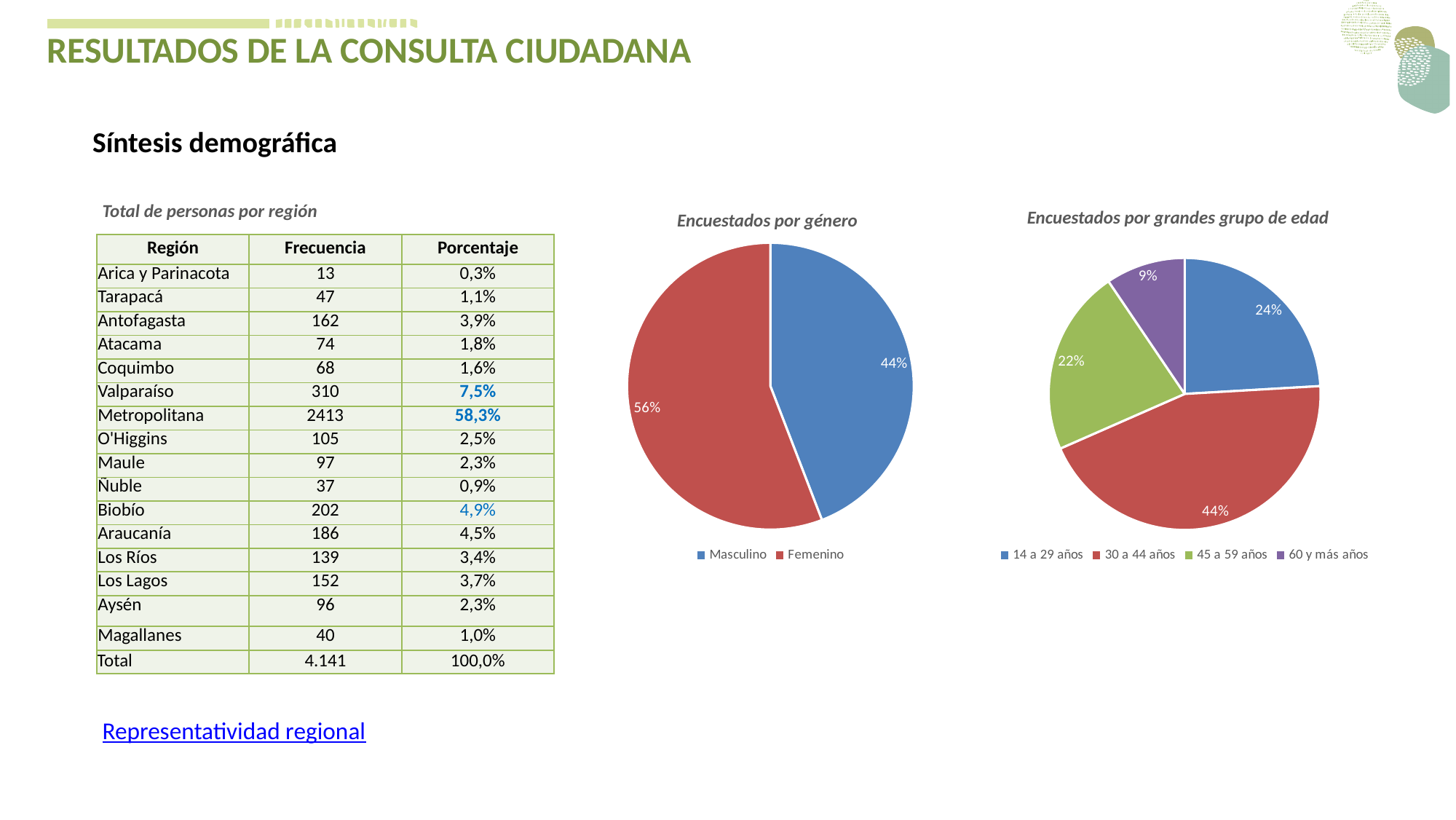
In the 'Encuestados por grandes grupo de edad' chart, what share is '60 y más años'? 9% In the 'Encuestados por género' chart, what is the difference between the Femenino and Masculino shares? 12% In the 'Encuestados por género' chart, which category has the larger share? Femenino In the 'Encuestados por género' chart, what share is Masculino? 44% How many categories does the legend of the 'Encuestados por grandes grupo de edad' chart list? 4 In the 'Encuestados por grandes grupo de edad' chart, what is the difference between the '14 a 29 años' and '45 a 59 años' shares? 2% In the 'Encuestados por grandes grupo de edad' chart, which age group has the smallest share? 60 y más años In the 'Encuestados por grandes grupo de edad' chart, which age group has the largest share? 30 a 44 años What kind of chart is 'Encuestados por género'? Pie chart In the 'Encuestados por género' chart, what share is Femenino? 56% In the 'Encuestados por grandes grupo de edad' chart, what share is '30 a 44 años'? 44% In the 'Encuestados por grandes grupo de edad' chart, what share is '45 a 59 años'? 22%